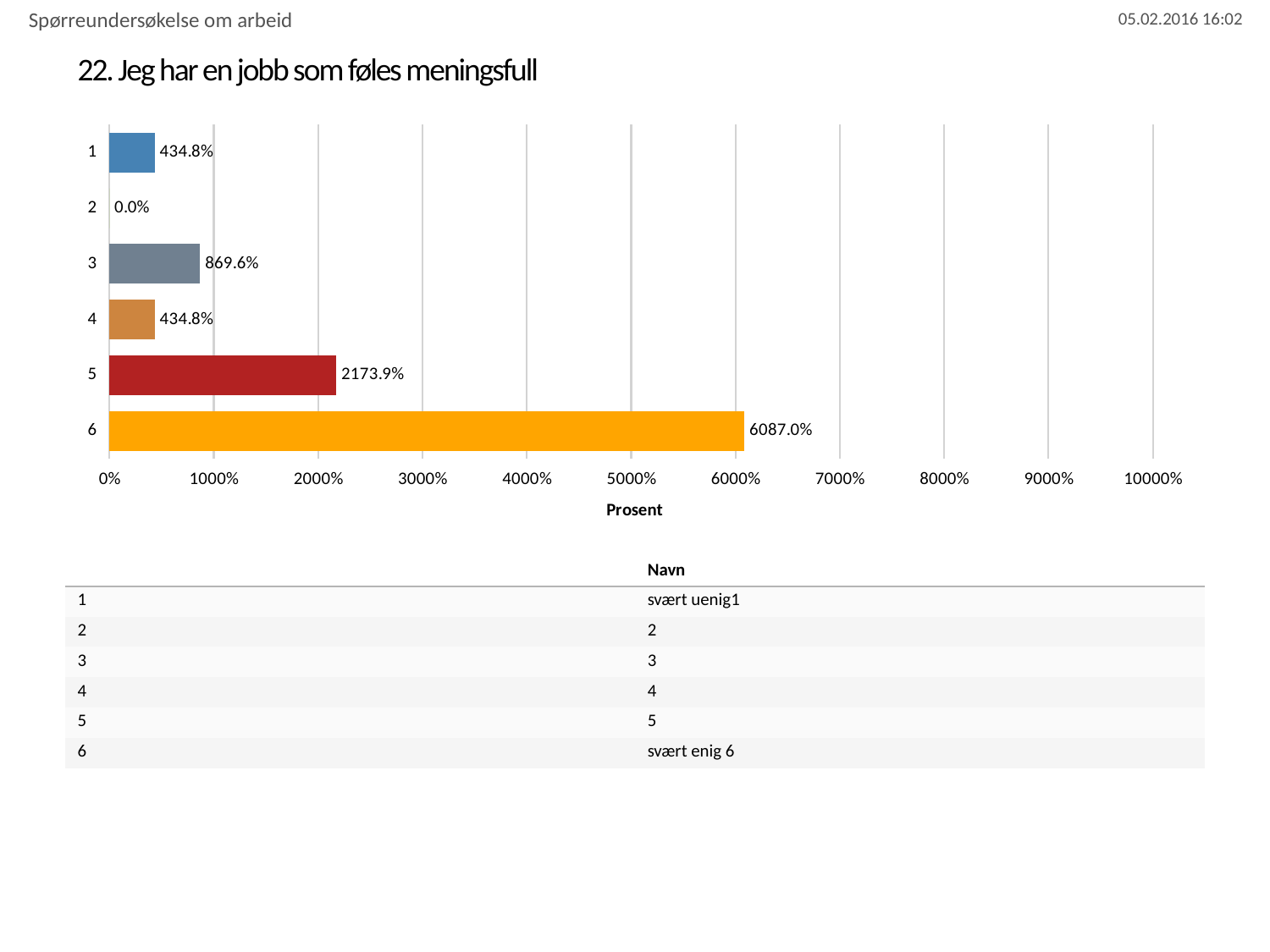
Which category has the lowest value? 2 Which is larger, the value for category 3 or the value for category 4? 3 What is the value for category 5? 2173.9% What is the value for category 3? 869.6% Is the value for category 5 greater or less than 2000%? greater What kind of chart is shown on the slide? bar chart Which category has the highest value? 6 What is the difference between the values for category 6 and category 5? 3913.1% What is the title of the x axis? Prosent What is the value for category 6? 6087.0% How many categories are shown on the chart? 6 What is the value for category 2? 0.0%